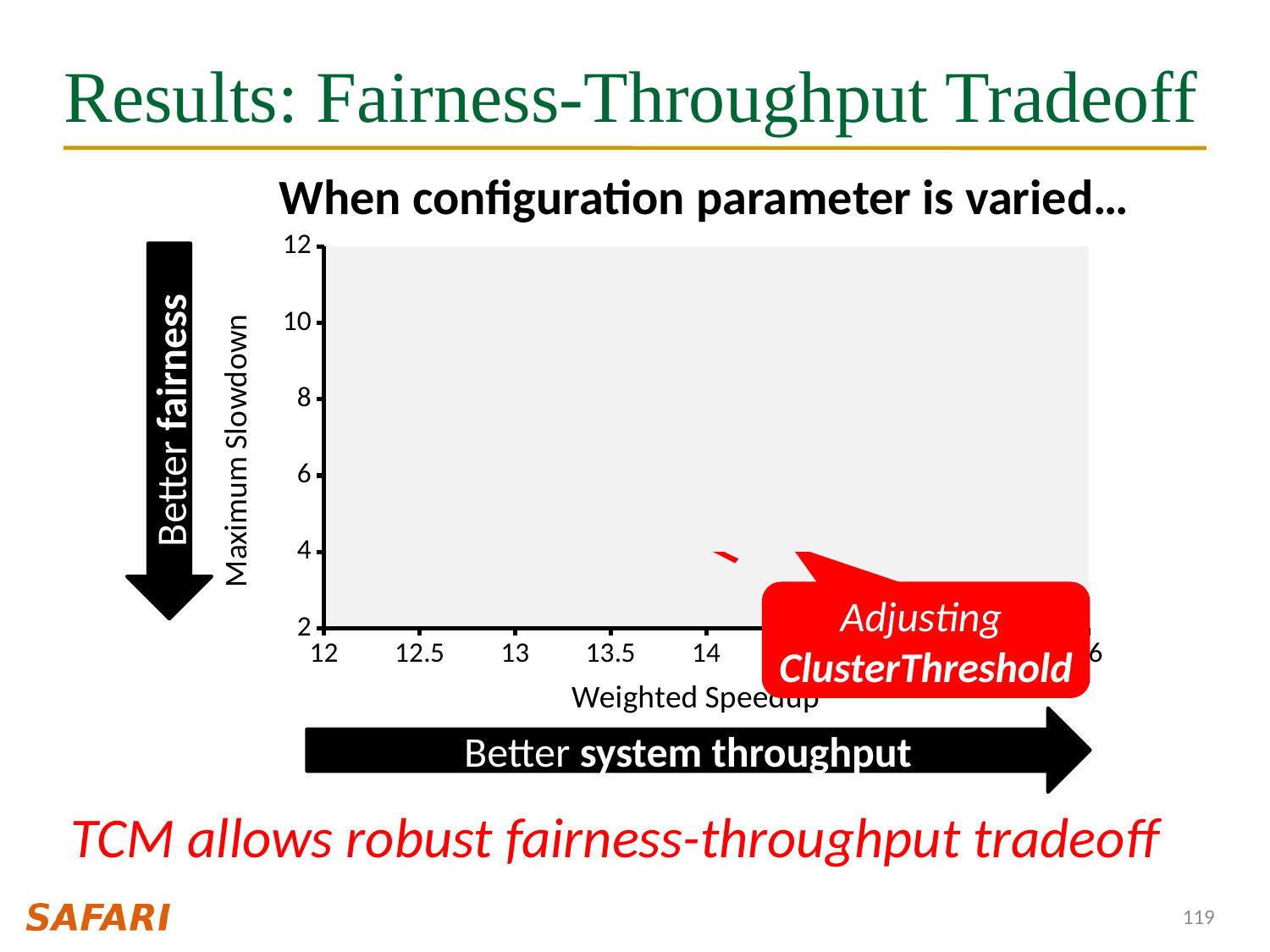
What kind of chart is shown on the slide? scatter chart What is the label of the y axis of the chart? Maximum Slowdown Is the Maximum Slowdown of the visible red data point greater or less than 6? less Is the Weighted Speedup of the visible red data point greater or less than 13.5? greater Is the Weighted Speedup of the visible red data point greater or less than 15? less What is the label of the x axis of the chart? Weighted Speedup